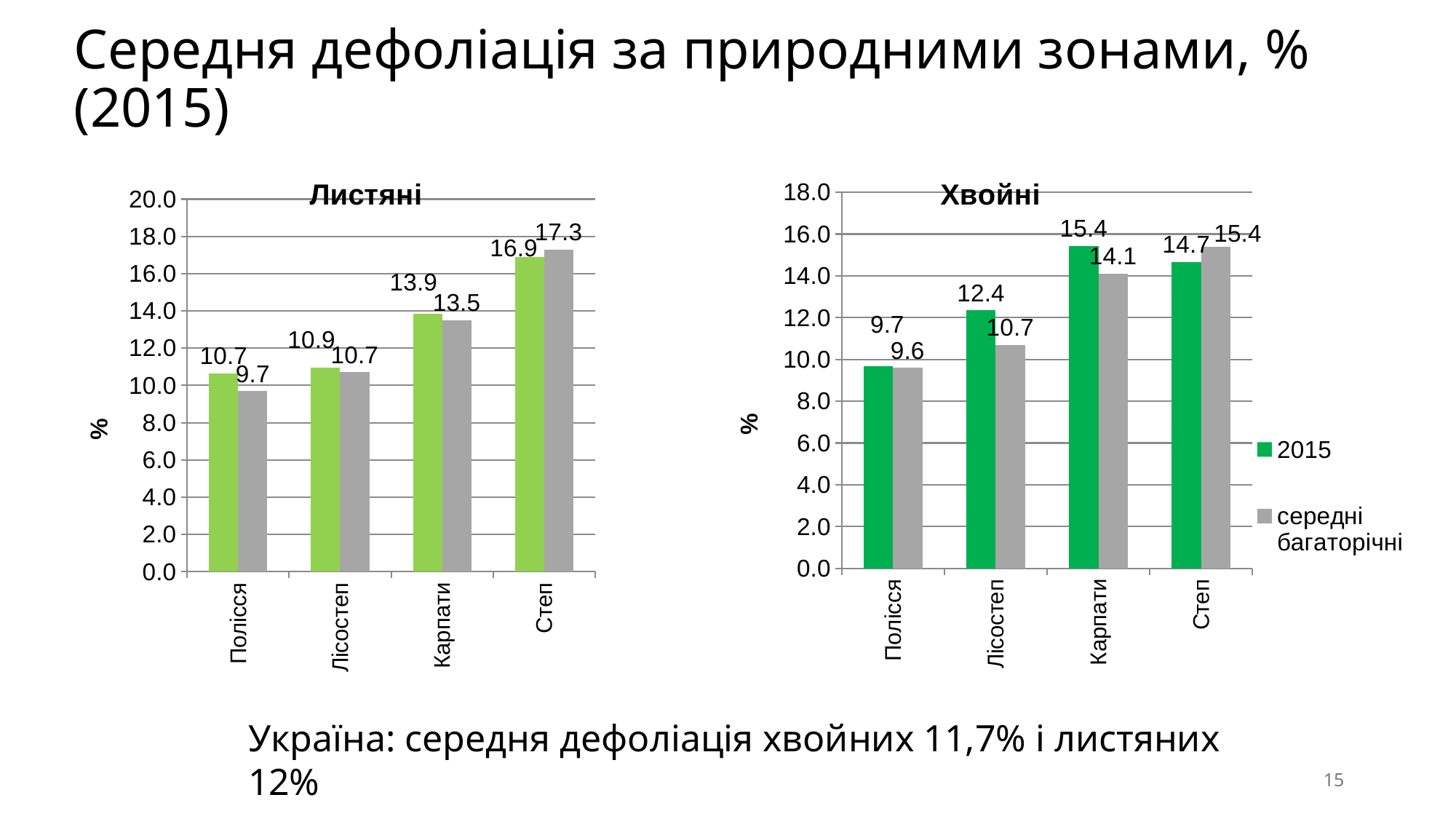
In the 'Хвойні' chart, what is the 'середні багаторічні' value for Лісостеп? 10.7 In the 'Хвойні' chart, is the 2015 value for Полісся greater or less than 10.0? less How many categories are shown on the x axis of the 'Листяні' chart? 4 In the 'Хвойні' chart, which category has the highest 2015 value? Карпати In the 'Хвойні' chart, what is the 2015 value for Карпати? 15.4 In the 'Листяні' chart, which category has the lowest grey-bar value? Полісся In the 'Листяні' chart, what value is labelled on the green bar for Степ? 16.9 In the 'Хвойні' chart, what is the difference between the 2015 value and the 'середні багаторічні' value for Лісостеп? 1.7 In the 'Листяні' chart, what value is labelled on the grey bar for Полісся? 9.7 In the 'Листяні' chart, which is larger for Степ: the green bar or the grey bar? the grey bar How many series does the legend of the 'Хвойні' chart list? 2 What type of chart is the 'Листяні' chart? bar chart